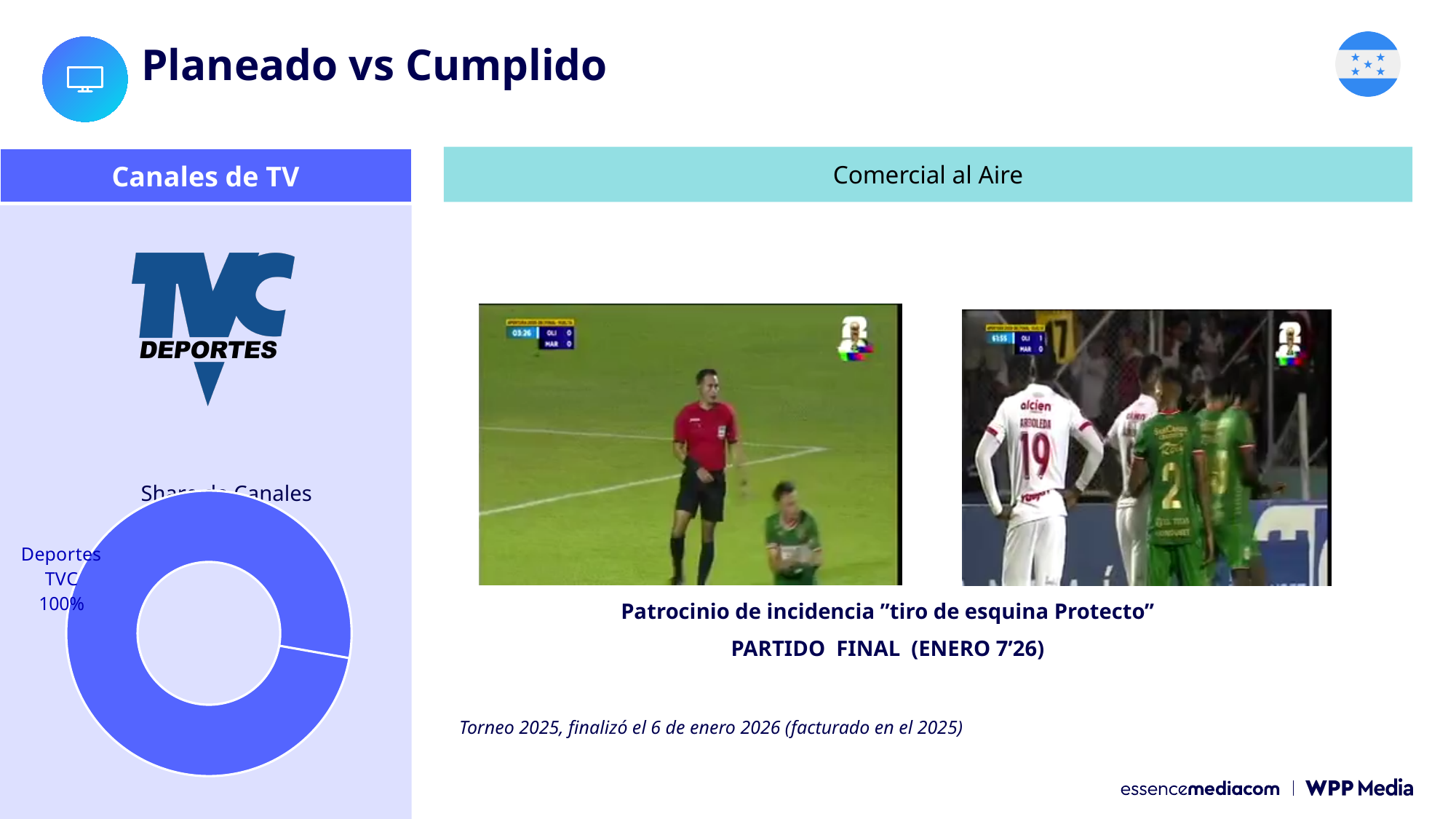
What is the title of the doughnut chart on the left of the slide? Share de Canales In the 'Share de Canales' chart, is the share for Deportes TVC greater or less than 50%? greater In the 'Share de Canales' chart, what share is shown for Deportes TVC? 100% In the 'Share de Canales' chart, which channel holds the largest share? Deportes TVC What colour is the Deportes TVC slice in the 'Share de Canales' chart? Blue How many labeled categories does the 'Share de Canales' chart show? 1 What kind of chart is shown under the 'Canales de TV' column? Doughnut chart